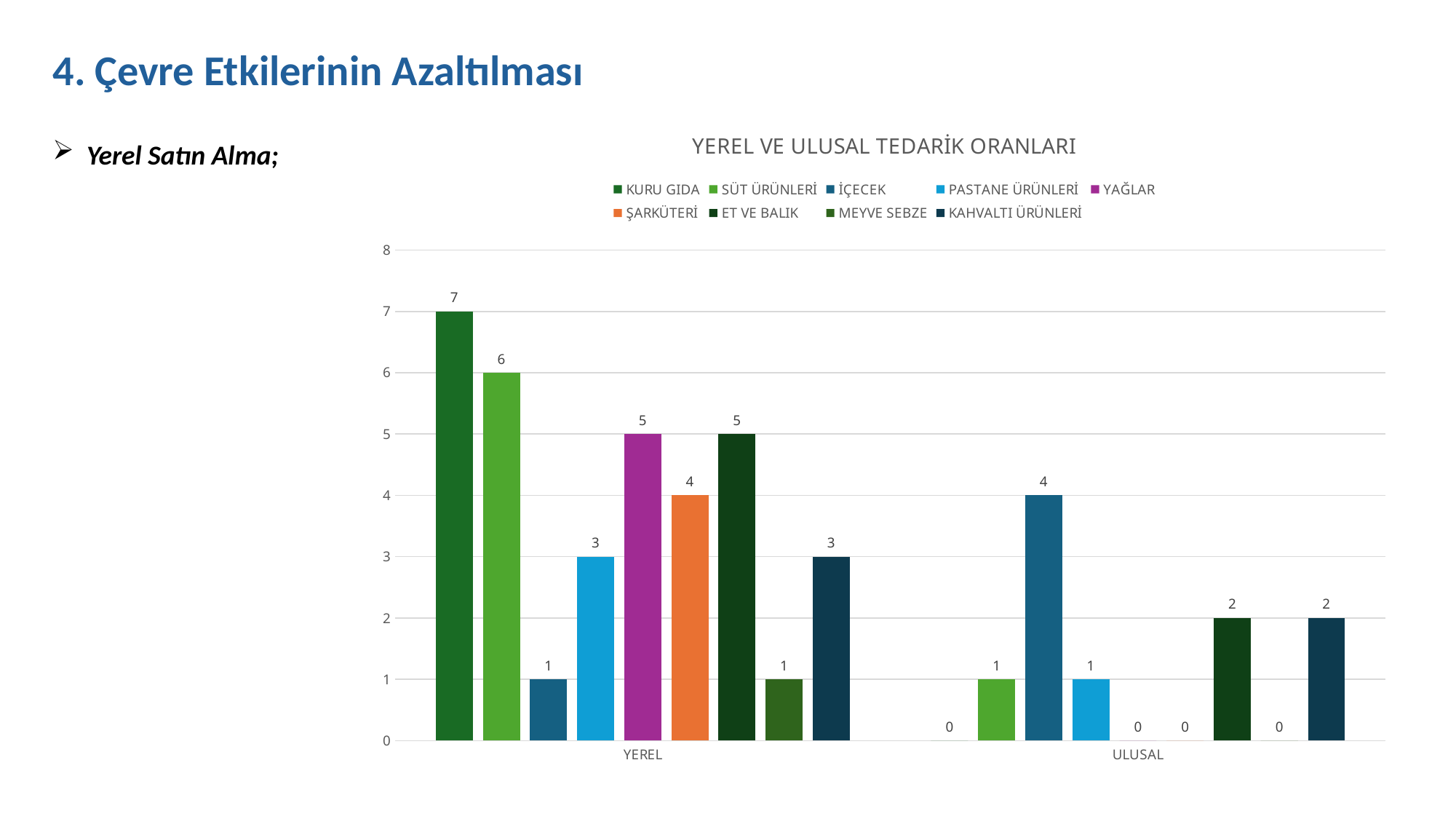
Which is larger in the YEREL category: PASTANE ÜRÜNLERİ or YAĞLAR? YAĞLAR What is the difference between the İÇECEK value in ULUSAL and the İÇECEK value in YEREL? 3 What is the difference between the KURU GIDA value and the SÜT ÜRÜNLERİ value in the YEREL category? 1 What is the value for İÇECEK in the ULUSAL category? 4 Which series has the highest value in the YEREL category? KURU GIDA How many categories are shown on the x axis? 2 How many series does the legend list? 9 Which series has the highest value in the ULUSAL category? İÇECEK What is the value for ŞARKÜTERİ in the YEREL category? 4 What type of chart is shown on the slide? Bar chart What is the value for ET VE BALIK in the ULUSAL category? 2 What is the value for KURU GIDA in the YEREL category? 7